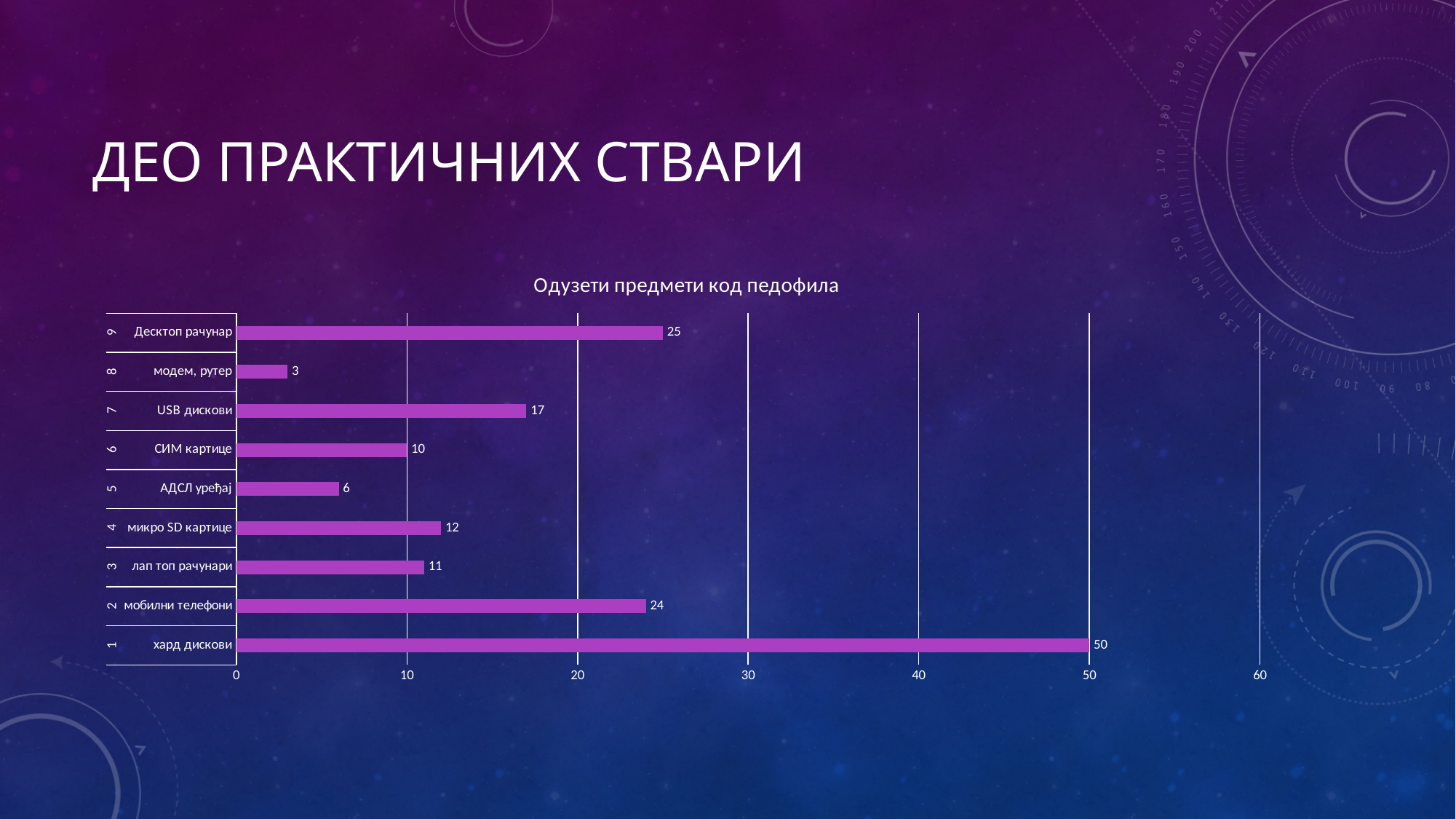
What is the title of the chart? Одузети предмети код педофила What is the value for хард дискови? 50 Which category has the lowest value? модем, рутер How many categories are shown in the chart? 9 What is the value for мобилни телефони? 24 Which category has the highest value? хард дискови What is the difference between the values for хард дискови and USB дискови? 33 What is the value for USB дискови? 17 Which is larger, the value for микро SD картице or the value for АДСЛ уређај? микро SD картице What kind of chart is shown on the slide? bar chart What is the difference between the values for Десктоп рачунар and мобилни телефони? 1 What is the value for модем, рутер? 3